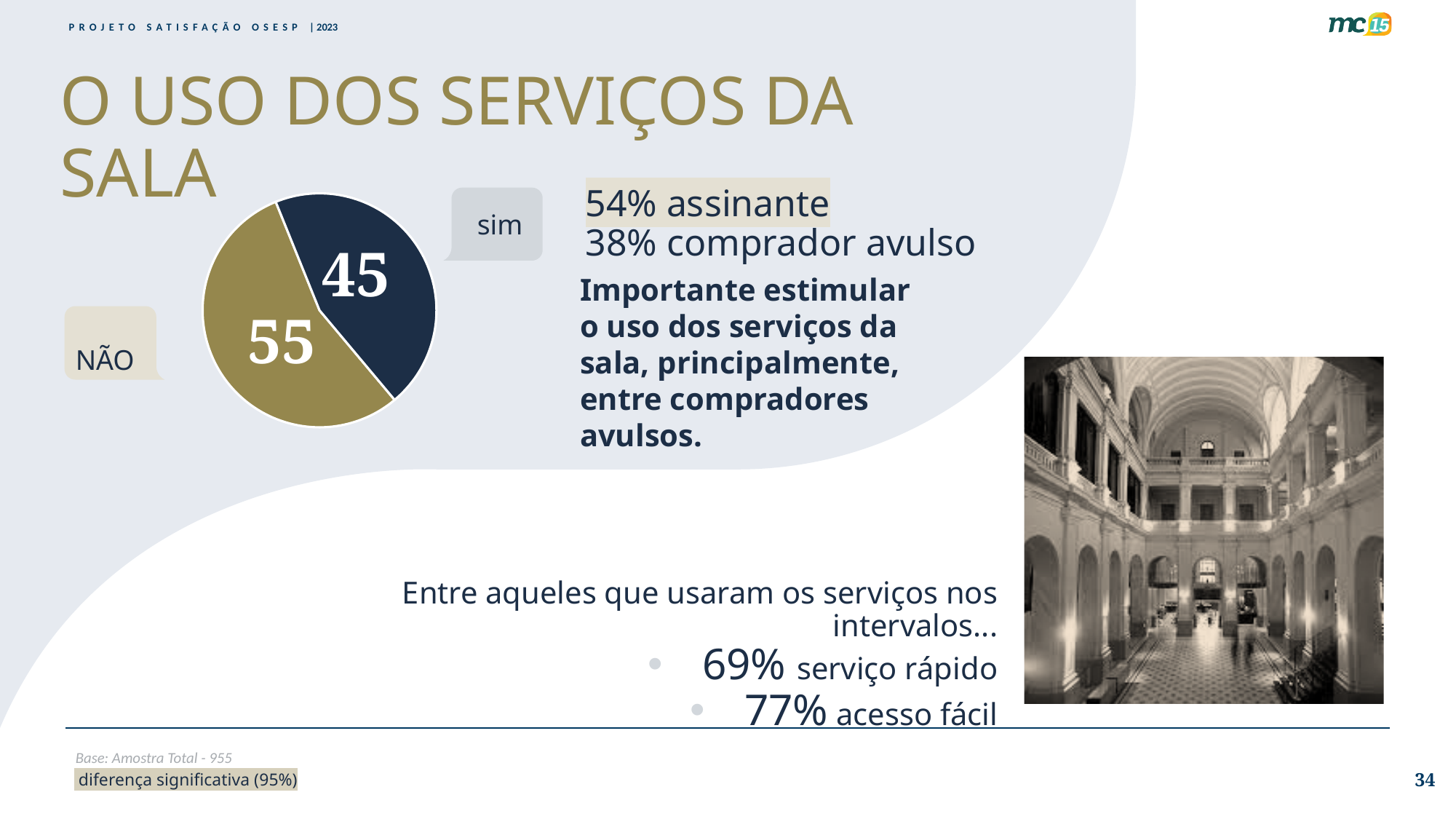
What share of the pie does the "sim" slice represent? 45% What is the value shown for the "NÃO" slice of the pie chart? 55 What is the value shown for the "sim" slice of the pie chart? 45 Which slice of the pie chart is the largest? NÃO What kind of chart is shown on the slide? pie chart Which is larger in the pie chart, "sim" or "NÃO"? NÃO What colour is the "NÃO" slice of the pie chart? olive gold Which slice of the pie chart is the smallest? sim How many slices does the pie chart have? 2 What is the difference between the "NÃO" and "sim" values in the pie chart? 10 What colour is the "sim" slice of the pie chart? dark navy blue What share of the pie does the "NÃO" slice represent? 55%